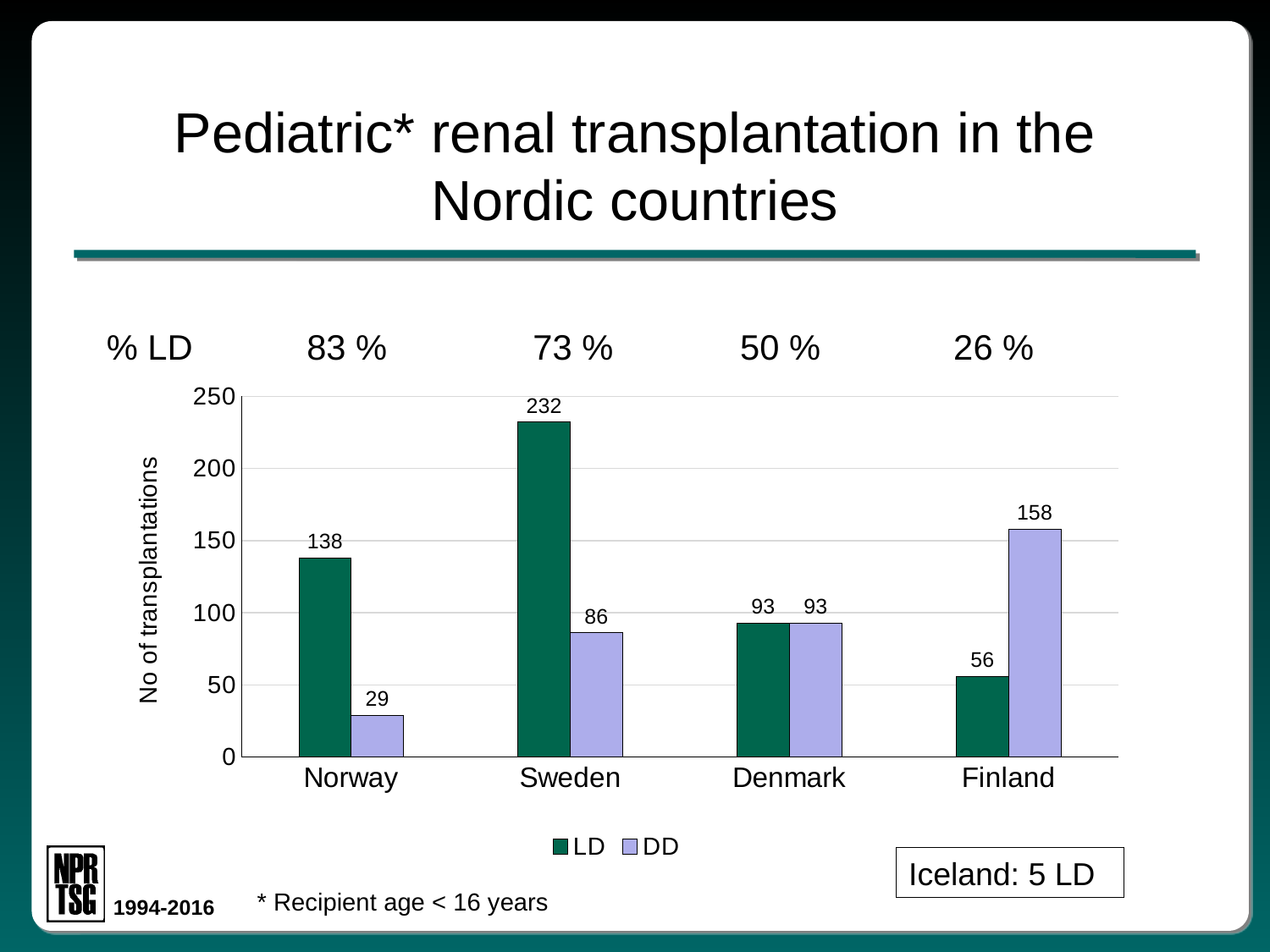
How many series does the legend list? 2 What is the LD value for Sweden? 232 What is the DD value for Finland? 158 How many countries are shown on the x axis of the chart? 4 What kind of chart is shown on the slide? bar chart What is the DD value for Norway? 29 What is the label of the y axis? No of transplantations Is the LD value for Denmark greater or less than 100? less Which is larger for Finland, the LD value or the DD value? DD Which country has the lowest DD value? Norway Which country has the highest LD value? Sweden What is the difference between the LD and DD values for Norway? 109